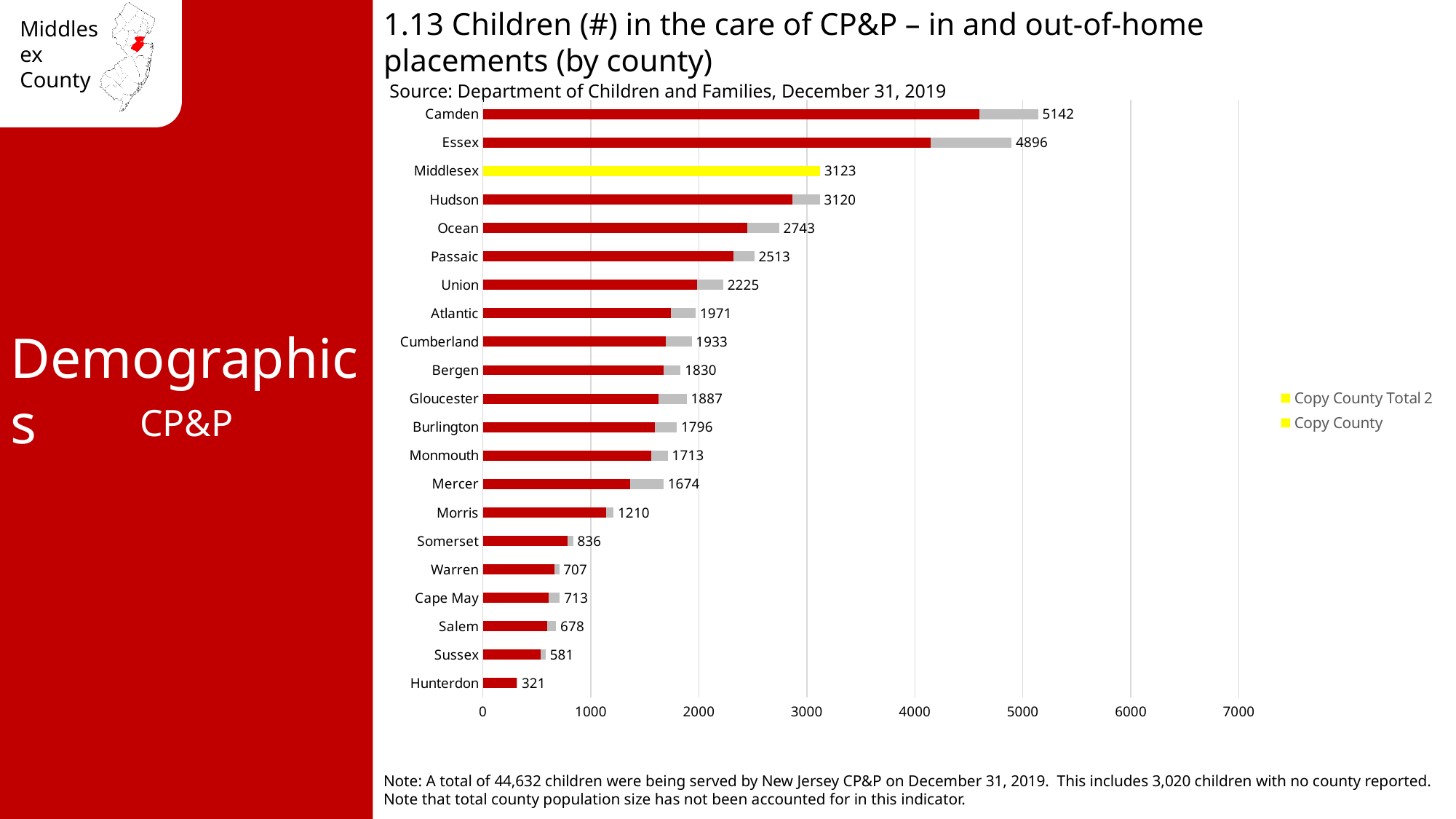
What is the value shown for Hunterdon county? 321 What kind of chart is shown on the slide? Bar chart What is the total number of children in the care of CP&P for Camden county? 5142 How many series does the legend list? 2 Which county has the highest number of children in the care of CP&P? Camden How many counties are shown in the chart? 21 Is the value for Union greater or less than 2000? greater What is the difference between the values for Camden and Essex? 246 What is the difference between the values for Middlesex and Hudson? 3 Which county has the lowest number of children in the care of CP&P? Hunterdon Which county has a larger value, Bergen or Gloucester? Gloucester What is the value shown for Middlesex county? 3123